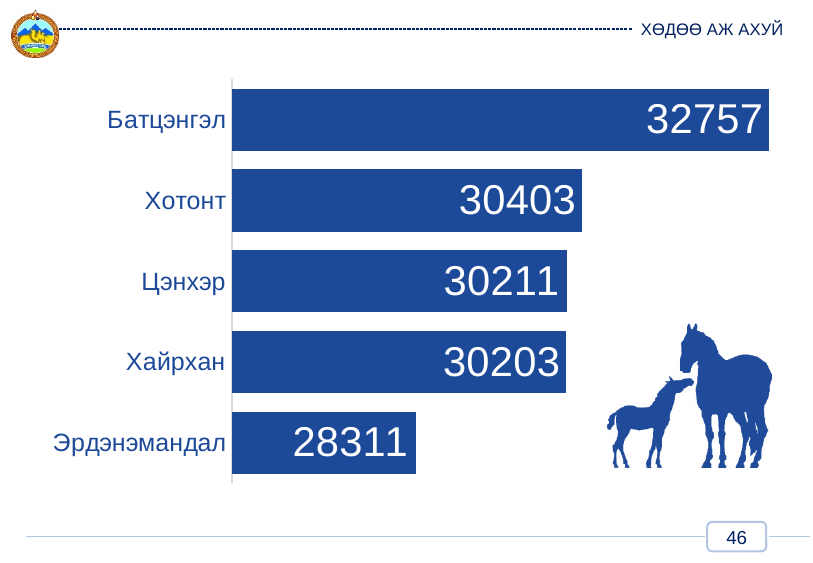
How many categories are shown in the chart? 5 What is the value for Эрдэнэмандал? 28311 What is the difference between the values for Батцэнгэл and Эрдэнэмандал? 4446 What is the value for Батцэнгэл? 32757 Which is larger, the value for Хайрхан or the value for Эрдэнэмандал? Хайрхан What kind of chart is shown on the slide? bar chart What is the value for Хайрхан? 30203 Which category has the lowest value? Эрдэнэмандал Which category has the highest value? Батцэнгэл What is the value for Цэнхэр? 30211 What is the value for Хотонт? 30403 What is the difference between the values for Батцэнгэл and Хотонт? 2354